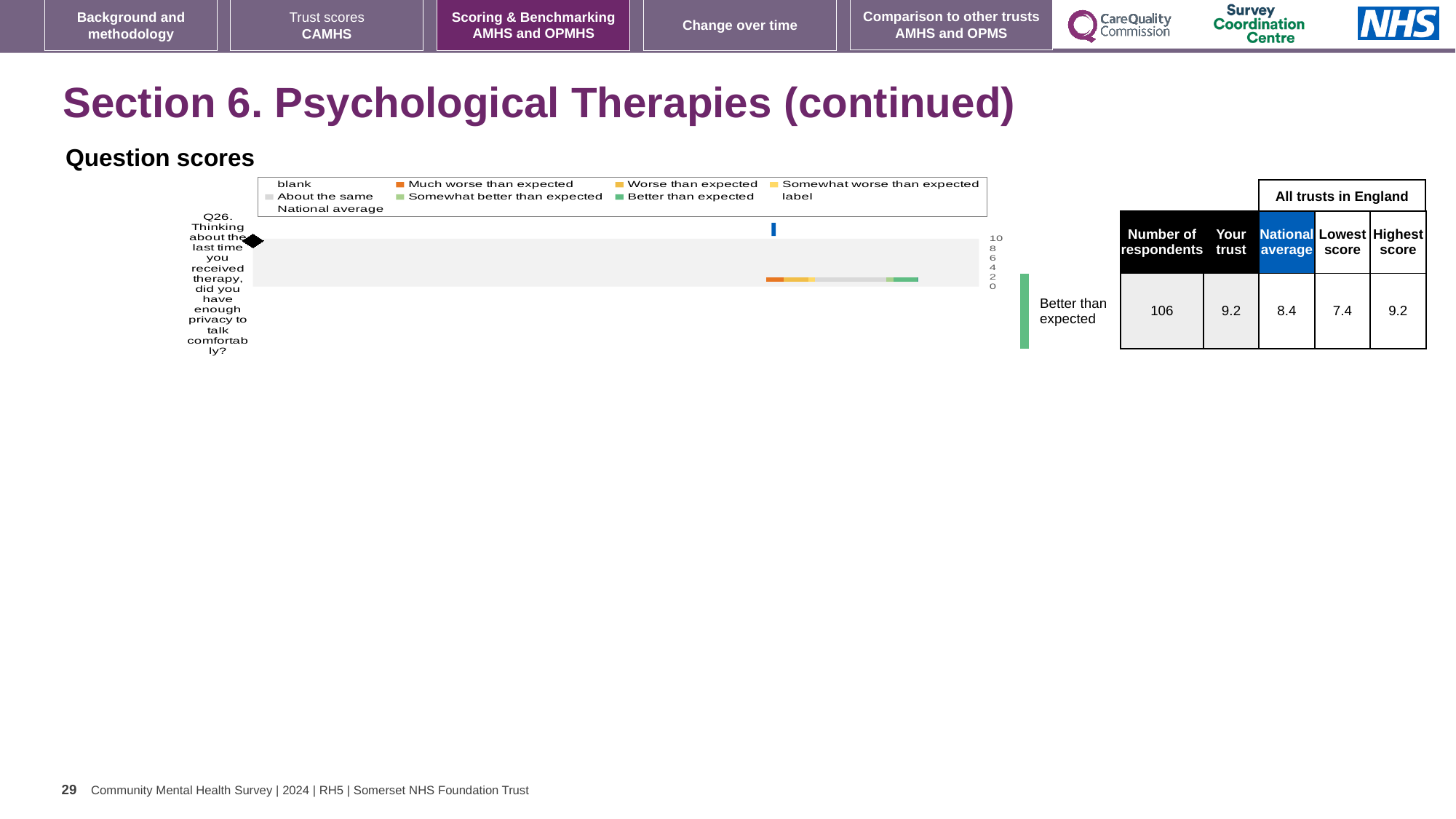
How many survey questions are plotted on the chart? 1 Which question is shown on the chart? Q26. Thinking about the last time you received therapy, did you have enough privacy to talk comfortably? What is the difference between the trust's score and the national average for Q26? 0.8 What is the lowest score among all trusts in England for Q26? 7.4 How many respondents answered Q26? 106 Which is larger for Q26, the trust's score or the national average? Your trust What is the national average score for Q26? 8.4 What is the highest score among all trusts in England for Q26? 9.2 What is the difference between the highest and lowest scores across all trusts for Q26? 1.8 What is the maximum value shown on the chart's score axis? 10 What benchmark category is Q26 assigned to on the chart? Better than expected What is the 'Your trust' score for Q26? 9.2